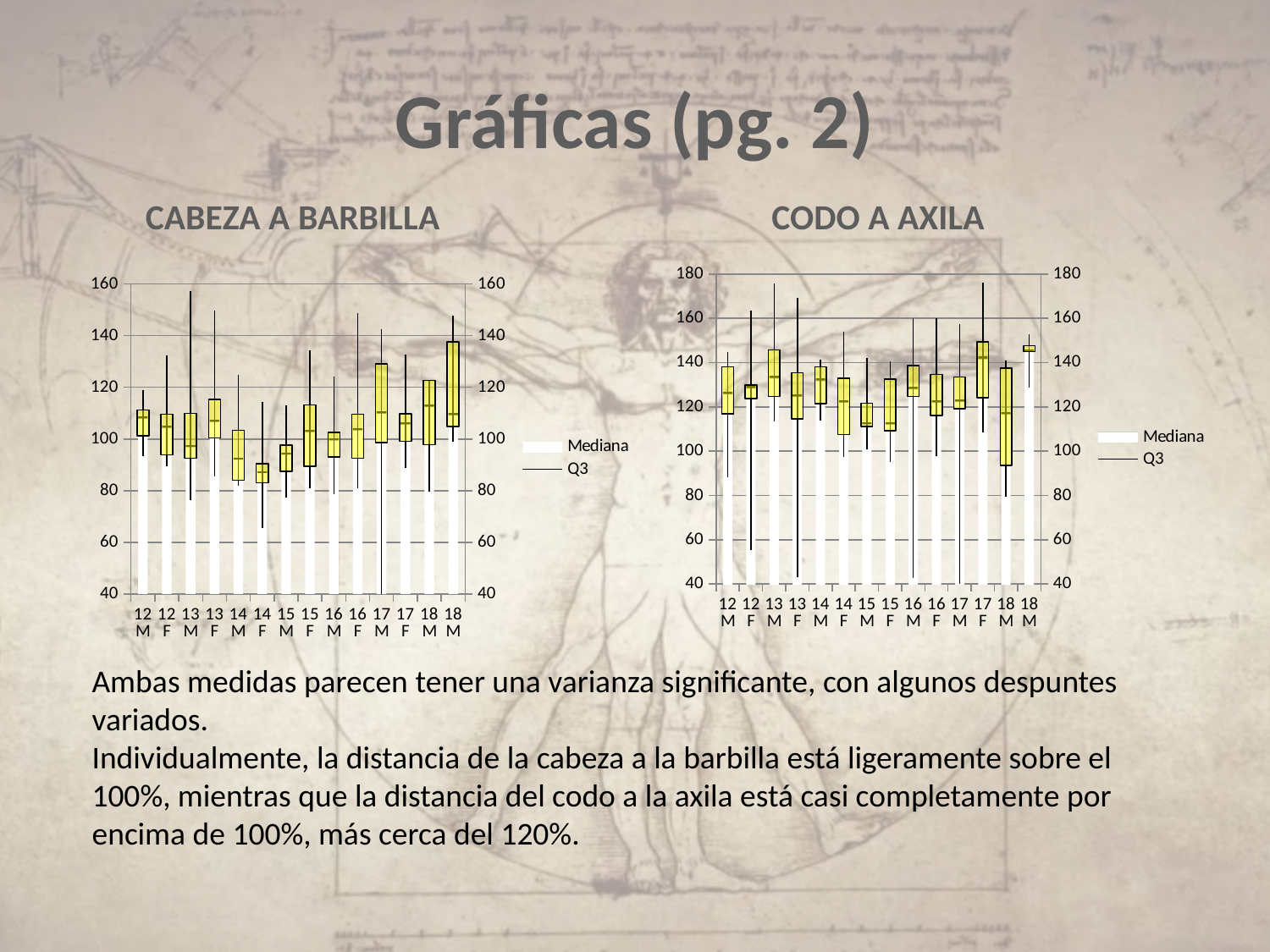
In the CABEZA A BARBILLA chart, which category has the highest upper whisker? 13 M What is the maximum value shown on the y axis of the CODO A AXILA chart? 180 In the CODO A AXILA chart, how many entries does the legend list? 2 In the CODO A AXILA chart, is the box for the last 18 M category greater or less than 140? greater In the CABEZA A BARBILLA chart, is the box for 14 F greater or less than 100? less In the CODO A AXILA chart, which category has the lowest lower whisker? 17 M What kind of chart is the CABEZA A BARBILLA chart? Box plot (box-and-whisker chart) In the CABEZA A BARBILLA chart, which category has the lowest box? 14 F In the CODO A AXILA chart, is the box for 12 F greater or less than 120? greater In the CABEZA A BARBILLA chart, how many categories are shown on the x axis? 14 What are the two legend entries in the CABEZA A BARBILLA chart? Mediana and Q3